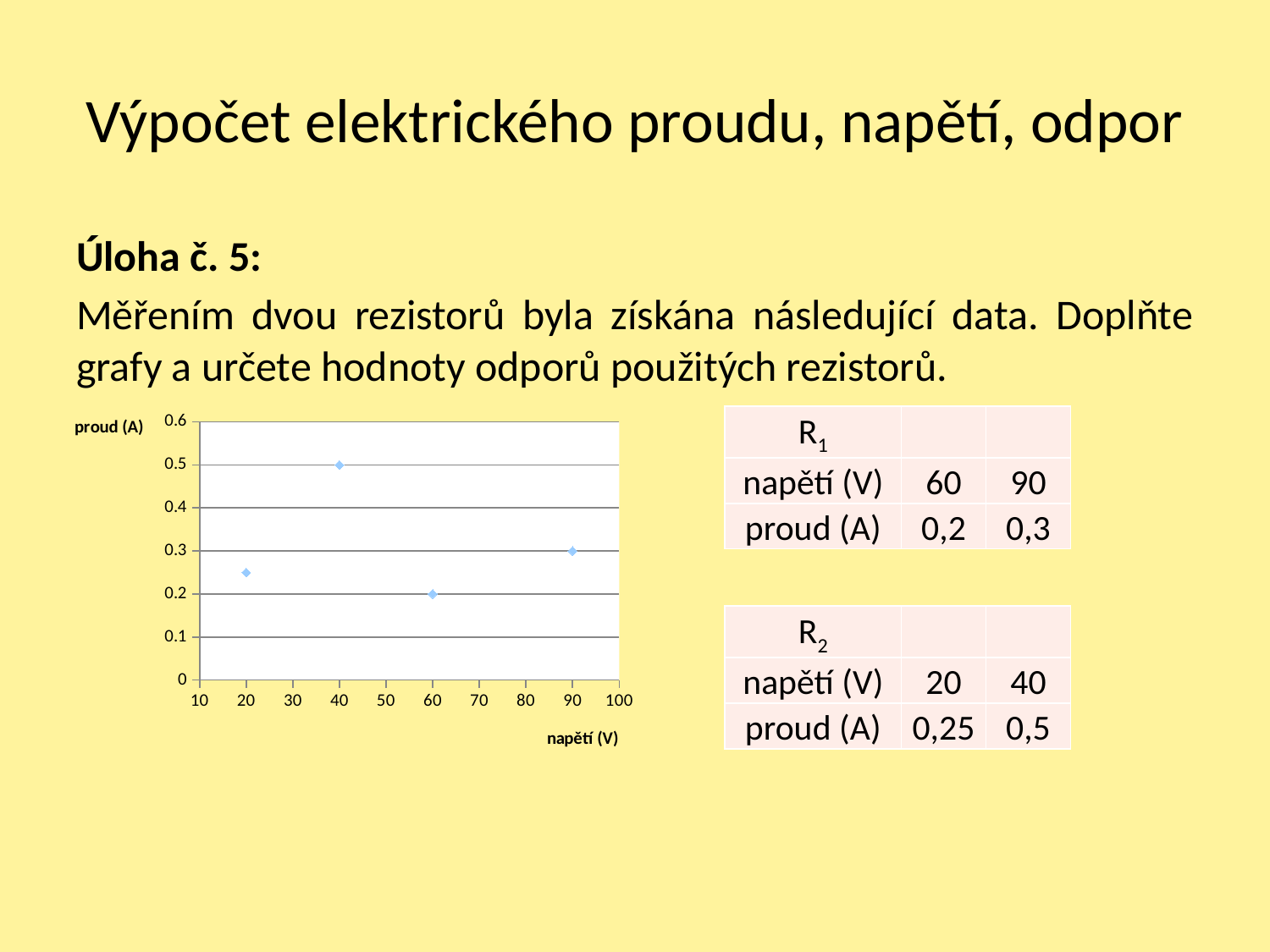
Which point has the larger current, the one at 40 V or the one at 90 V? 40 V What is the current (proud) plotted at 60 V? 0.2 What is the current (proud) plotted at 40 V? 0.5 What is the difference between the current at 40 V and the current at 60 V? 0.3 Is the current plotted at 90 V greater or less than 0.4? less What kind of chart is shown on the slide? scatter chart At which voltage is the plotted current lowest? 60 V How many data points are plotted on the chart? 4 At which voltage is the plotted current highest? 40 V What is the current (proud) plotted at 90 V? 0.3 What is the label of the vertical axis of the chart? proud (A) Is the current plotted at 20 V greater or less than 0.2? greater